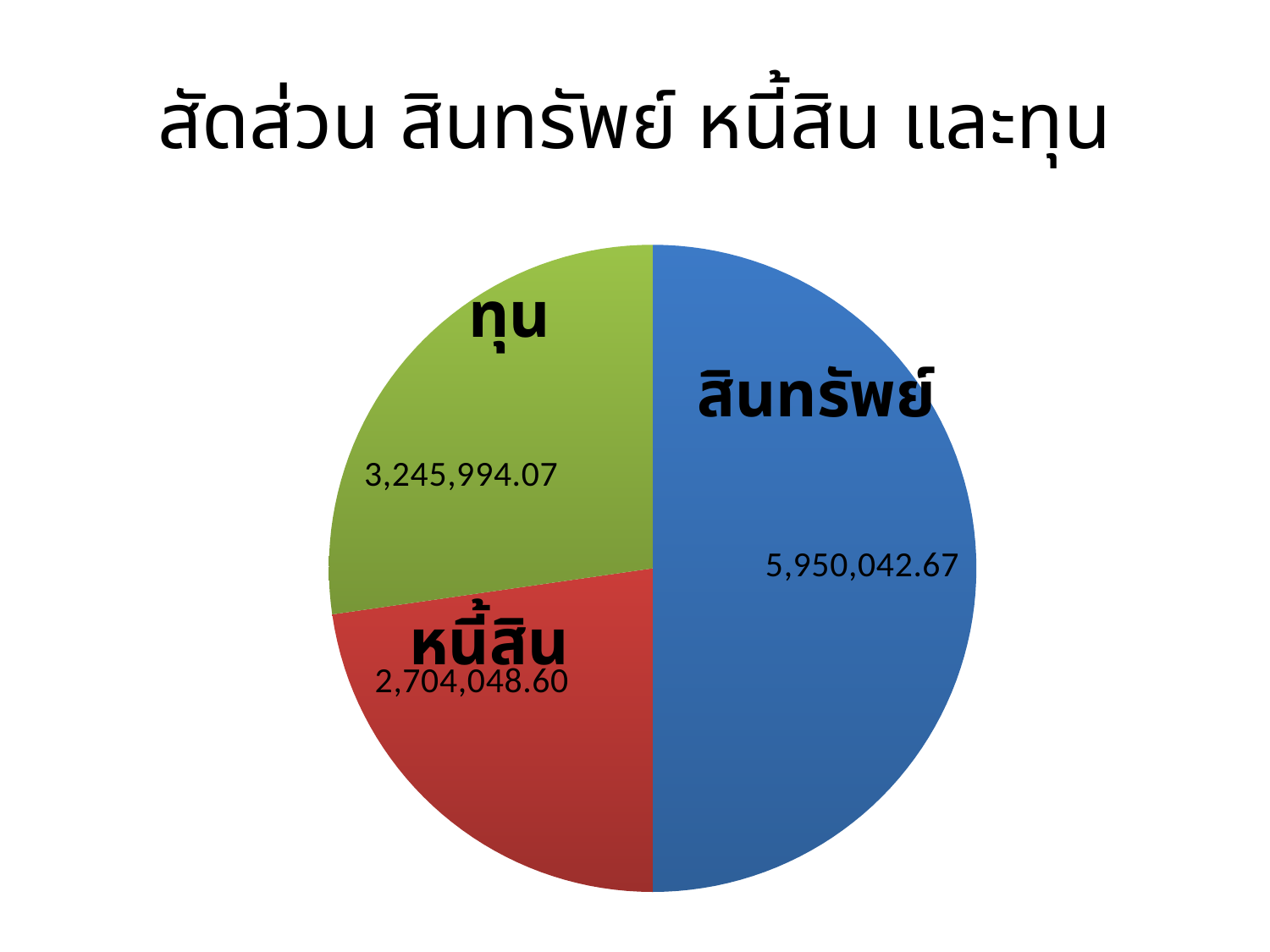
Which is larger, ทุน or หนี้สิน? ทุน Which slice has the smallest value? หนี้สิน How many slices does the pie chart have? 3 What is the value shown for สินทรัพย์? 5,950,042.67 What share of the pie does สินทรัพย์ represent? 50% What is the title of the chart? สัดส่วน สินทรัพย์ หนี้สิน และทุน What type of chart is shown on the slide? Pie chart What is the difference between the values for ทุน and หนี้สิน? 541,945.47 Which slice has the largest value? สินทรัพย์ What is the difference between the values for สินทรัพย์ and ทุน? 2,704,048.60 What is the value shown for หนี้สิน? 2,704,048.60 What is the value shown for ทุน? 3,245,994.07